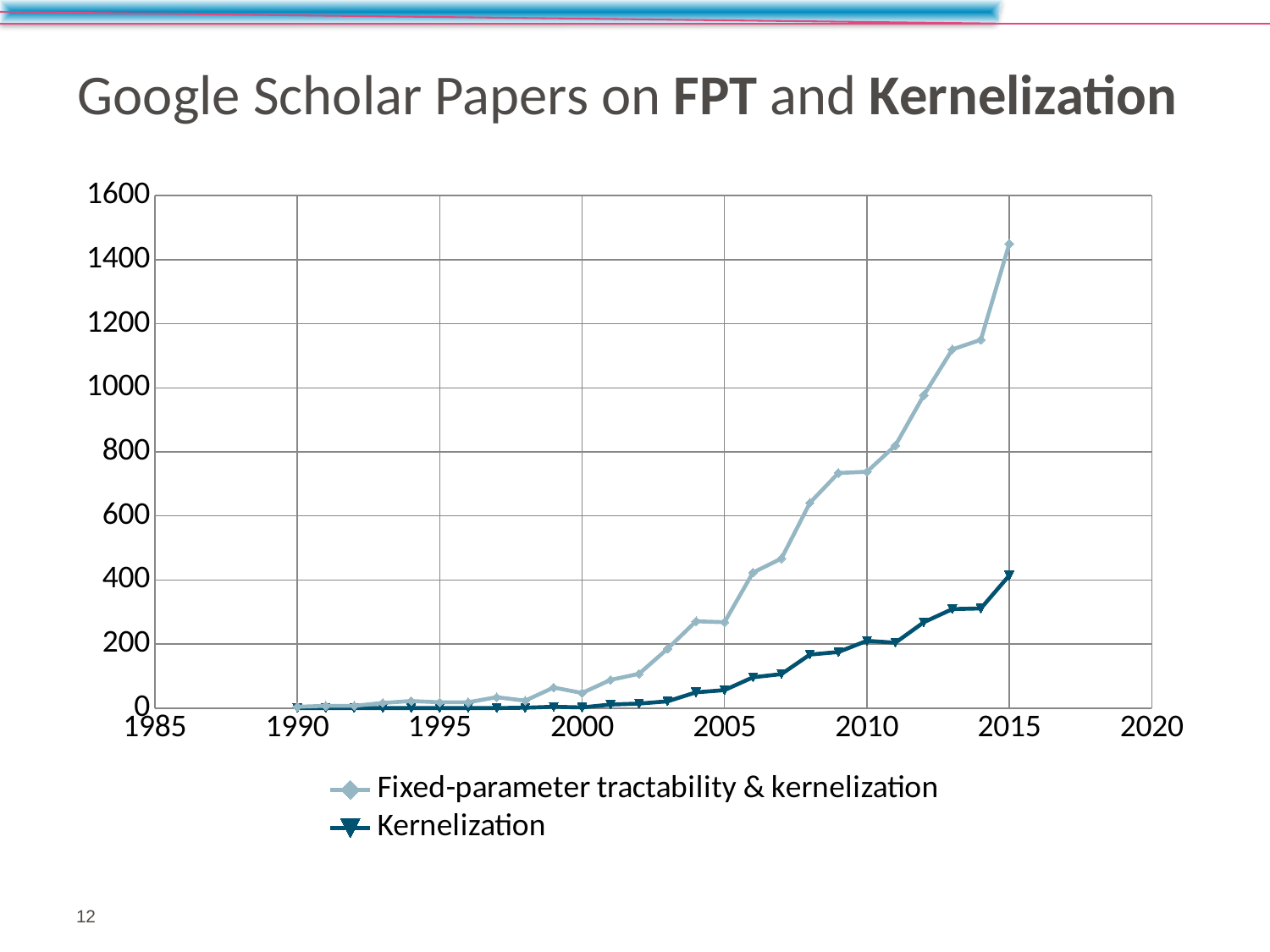
Is the value for Fixed-parameter tractability & kernelization in 2015 greater or less than 1400? greater Is the value for Fixed-parameter tractability & kernelization in 2005 greater or less than 200? greater In 2015, which series has the larger value, Fixed-parameter tractability & kernelization or Kernelization? Fixed-parameter tractability & kernelization What kind of chart is shown on the slide? line chart Which year has the highest value for the Kernelization series? 2015 Is the value for Fixed-parameter tractability & kernelization in 2010 greater or less than 800? less Do the values for the Kernelization series generally rise or fall from 1990 to 2015? rise Which year has the highest value for the Fixed-parameter tractability & kernelization series? 2015 How many series does the legend list? 2 What is the title of the slide containing the chart? Google Scholar Papers on FPT and Kernelization